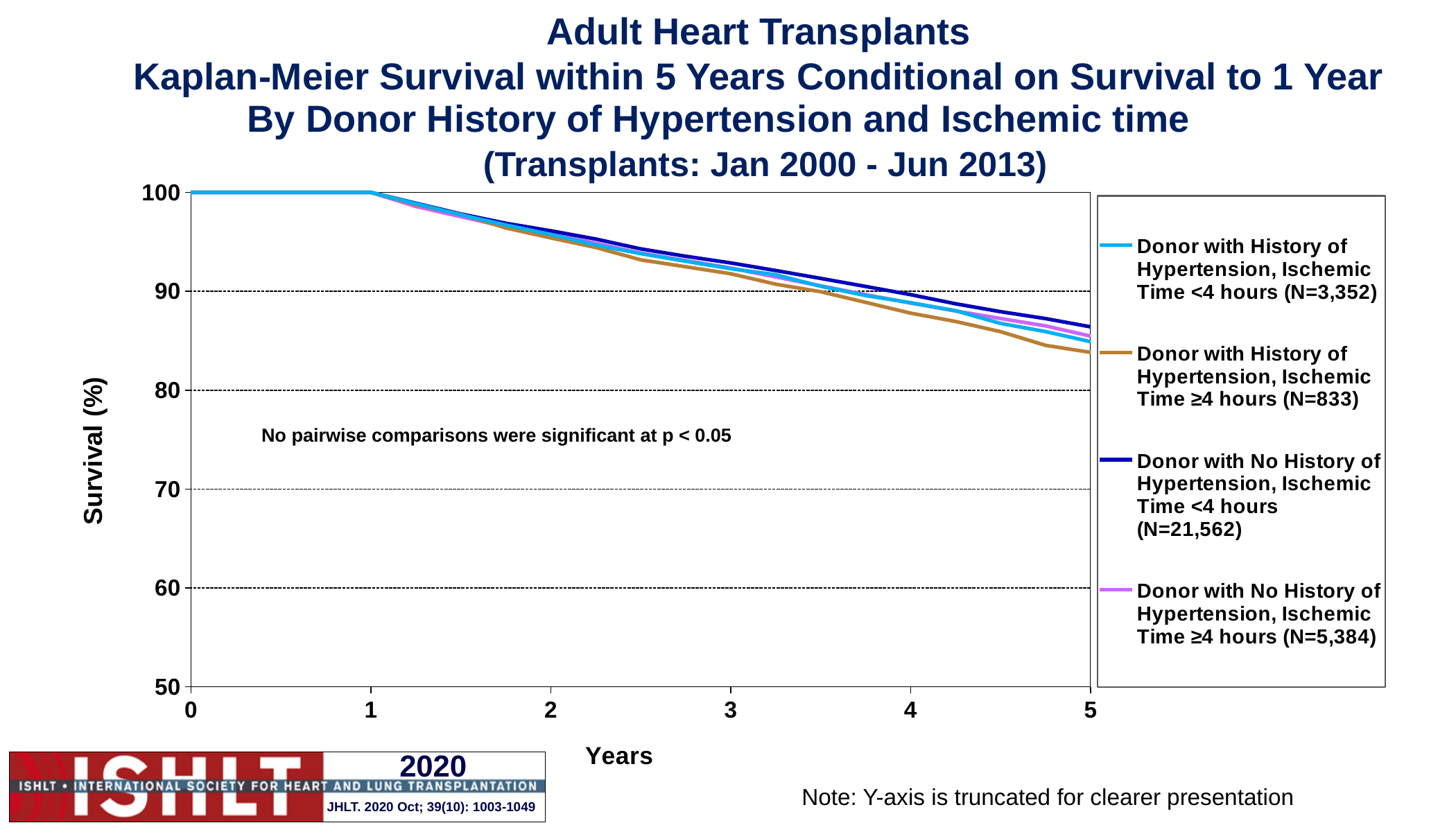
Is the survival value for Donor with History of Hypertension, Ischemic Time ≥4 hours at year 3 greater or less than 90? greater Is the survival value for Donor with History of Hypertension, Ischemic Time ≥4 hours at year 5 greater or less than 90? less Do the survival curves rise or fall as years increase from 1 to 5? fall Is the survival value for Donor with No History of Hypertension, Ischemic Time <4 hours at year 5 greater or less than 80? greater What is the sample size (N) for the Donor with No History of Hypertension, Ischemic Time <4 hours group? 21,562 What is the label of the y-axis? Survival (%) What is the survival value for all four groups at year 1? 100 Which group has the lowest survival at year 5? Donor with History of Hypertension, Ischemic Time ≥4 hours (N=833) What kind of chart is shown on the slide? line chart At year 5, which is larger: survival for Donor with No History of Hypertension, Ischemic Time <4 hours or for Donor with History of Hypertension, Ischemic Time ≥4 hours? Donor with No History of Hypertension, Ischemic Time <4 hours How many series does the legend list? 4